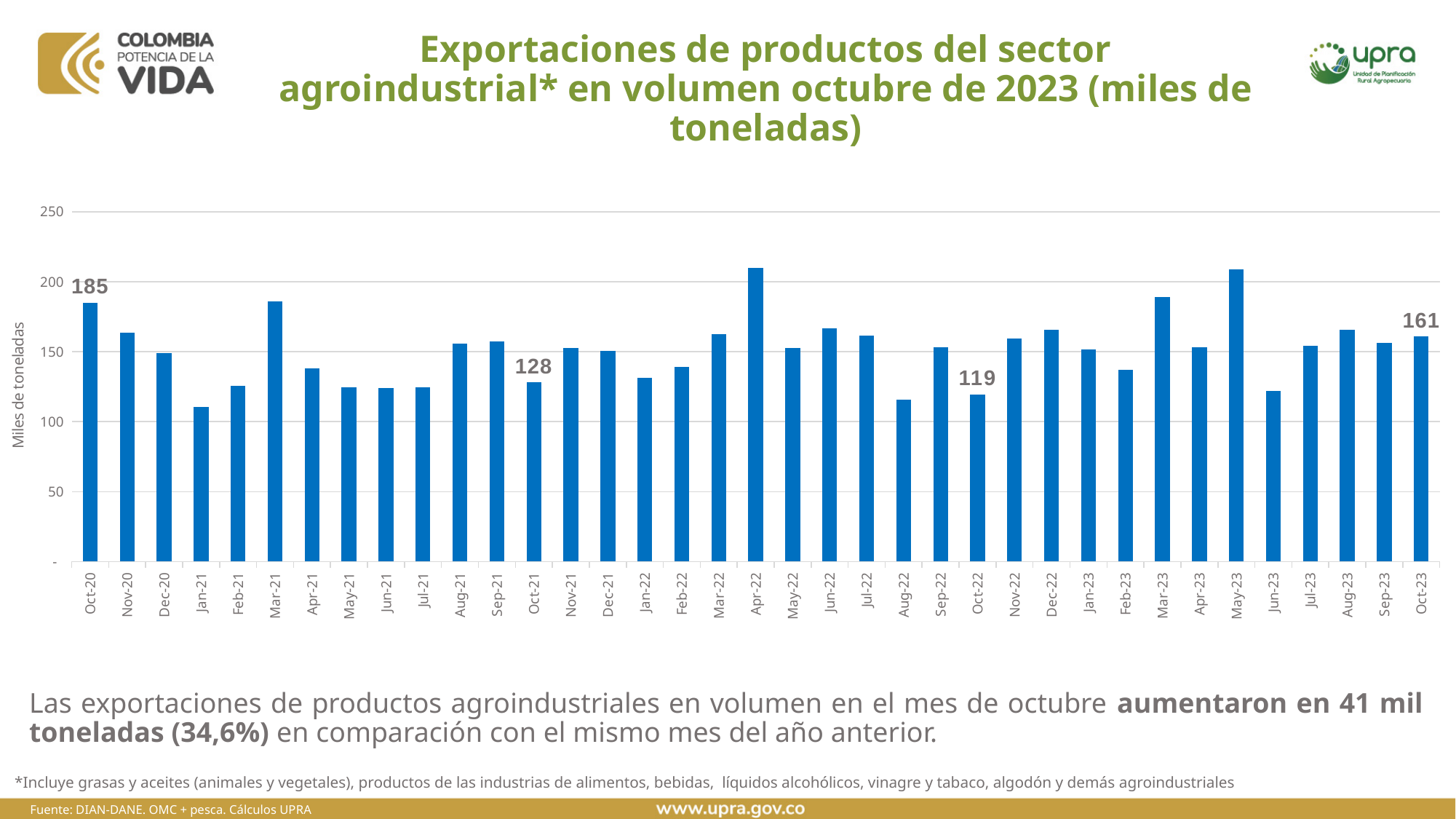
What is the value for Oct-21? 128 What is the difference between the values for Oct-21 and Oct-22? 9 Which is larger, the value for Oct-20 or the value for Oct-23? Oct-20 What kind of chart is shown on the slide? bar chart Is the value for Apr-22 greater or less than 200? greater What is the value for Oct-20? 185 What is the value for Oct-22? 119 How many months (bars) are shown in the chart? 37 What is the label of the vertical axis? Miles de toneladas What is the difference between the values for Oct-20 and Oct-21? 57 What is the value for Oct-23? 161 Is the value for Jan-21 greater or less than 150? less